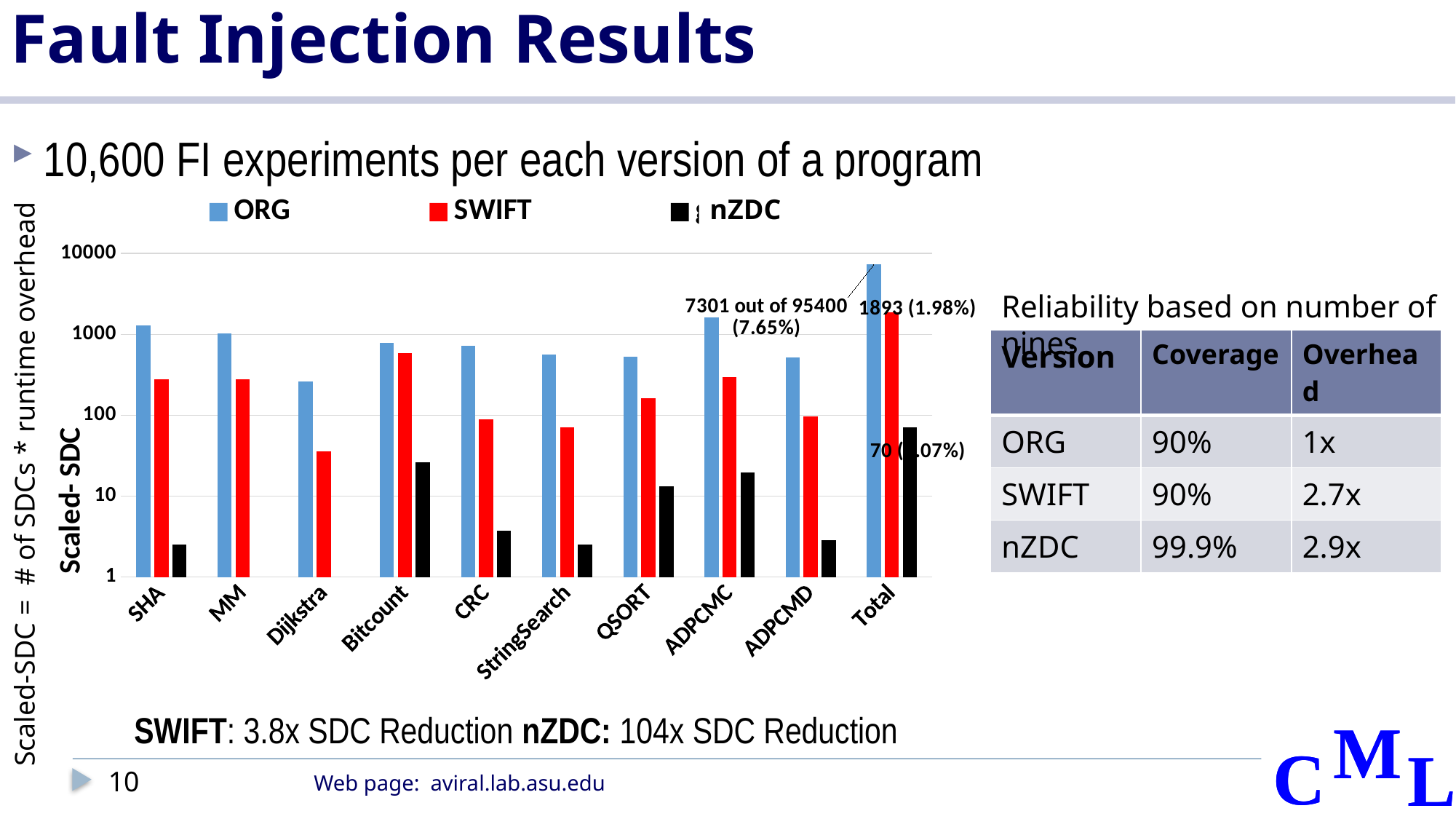
How many categories are shown along the x axis of the chart? 10 Which category has the highest ORG value? Total What kind of chart is shown on the slide? bar chart Which category has the lowest ORG value? Dijkstra What is the data label on the SWIFT bar for Total? 1893 (1.98%) For SHA, which is larger: the ORG value or the SWIFT value? ORG Is the ORG value for SHA greater or less than 1000? greater What is the Scaled-SDC value for nZDC in the Total category? 70 What is the data label on the ORG bar for Total? 7301 out of 95400 (7.65%) How many series does the chart legend list? 3 Is the SWIFT value for Dijkstra greater or less than 100? less What colour are the SWIFT bars in the chart? red